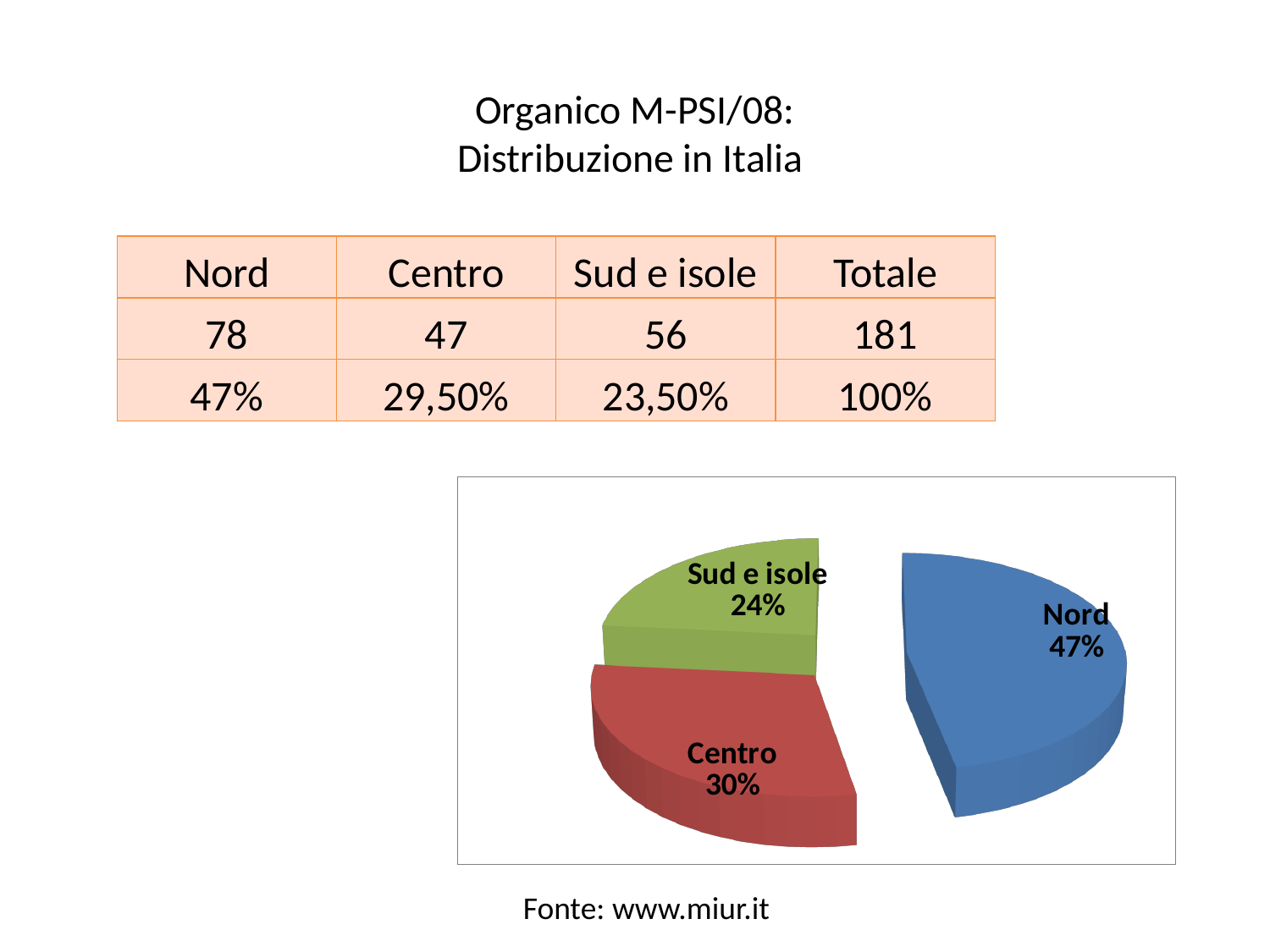
What kind of chart is shown on the slide? pie chart Which slice of the pie chart is the smallest? Sud e isole What is the difference in percentage points between the Centro and Sud e isole slices in the pie chart? 6 What share of the pie does the Centro slice represent? 30% What share of the pie does the Sud e isole slice represent? 24% Which is larger in the pie chart, Centro or Sud e isole? Centro What share of the pie does the Nord slice represent? 47% Which slice of the pie chart is the largest? Nord What is the difference in percentage points between the Nord and Centro slices in the pie chart? 17 What colour is the Nord slice in the pie chart? blue How many slices does the pie chart have? 3 What colour is the Centro slice in the pie chart? red